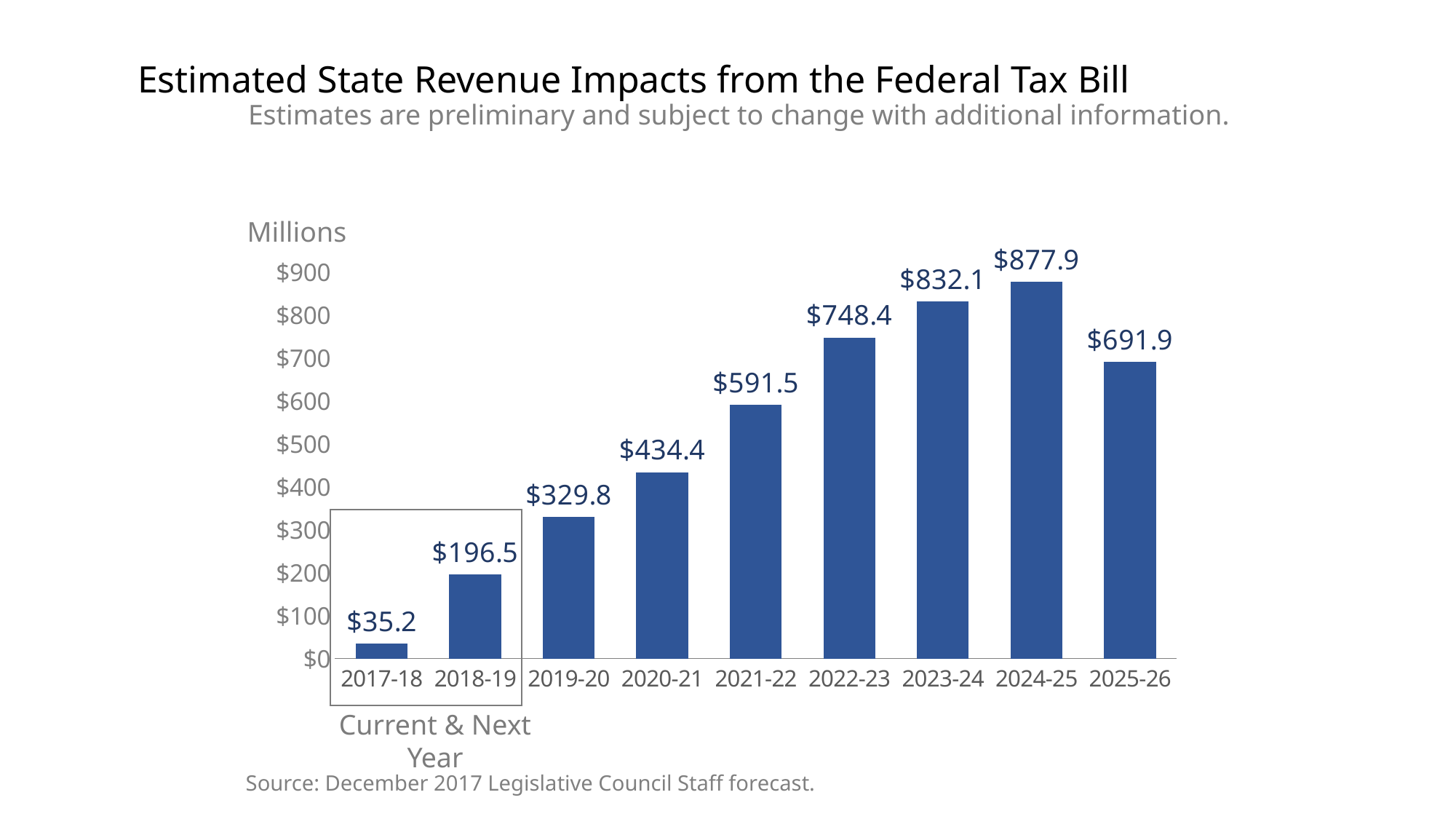
Is the value for 2020-21 greater or less than $400? greater Which fiscal year has the highest estimated revenue impact? 2024-25 What is the estimated state revenue impact for 2023-24? $832.1 What is the value shown for 2017-18? $35.2 What kind of chart is shown on the slide? Bar chart Which is larger, the value for 2021-22 or the value for 2025-26? 2025-26 How many fiscal years are shown on the x axis? 9 What is the difference between the values for 2018-19 and 2017-18? $161.3 What unit label is shown above the vertical axis? Millions Which fiscal year has the lowest estimated revenue impact? 2017-18 What is the difference between the values for 2024-25 and 2025-26? $186.0 What is the estimated state revenue impact for 2019-20? $329.8